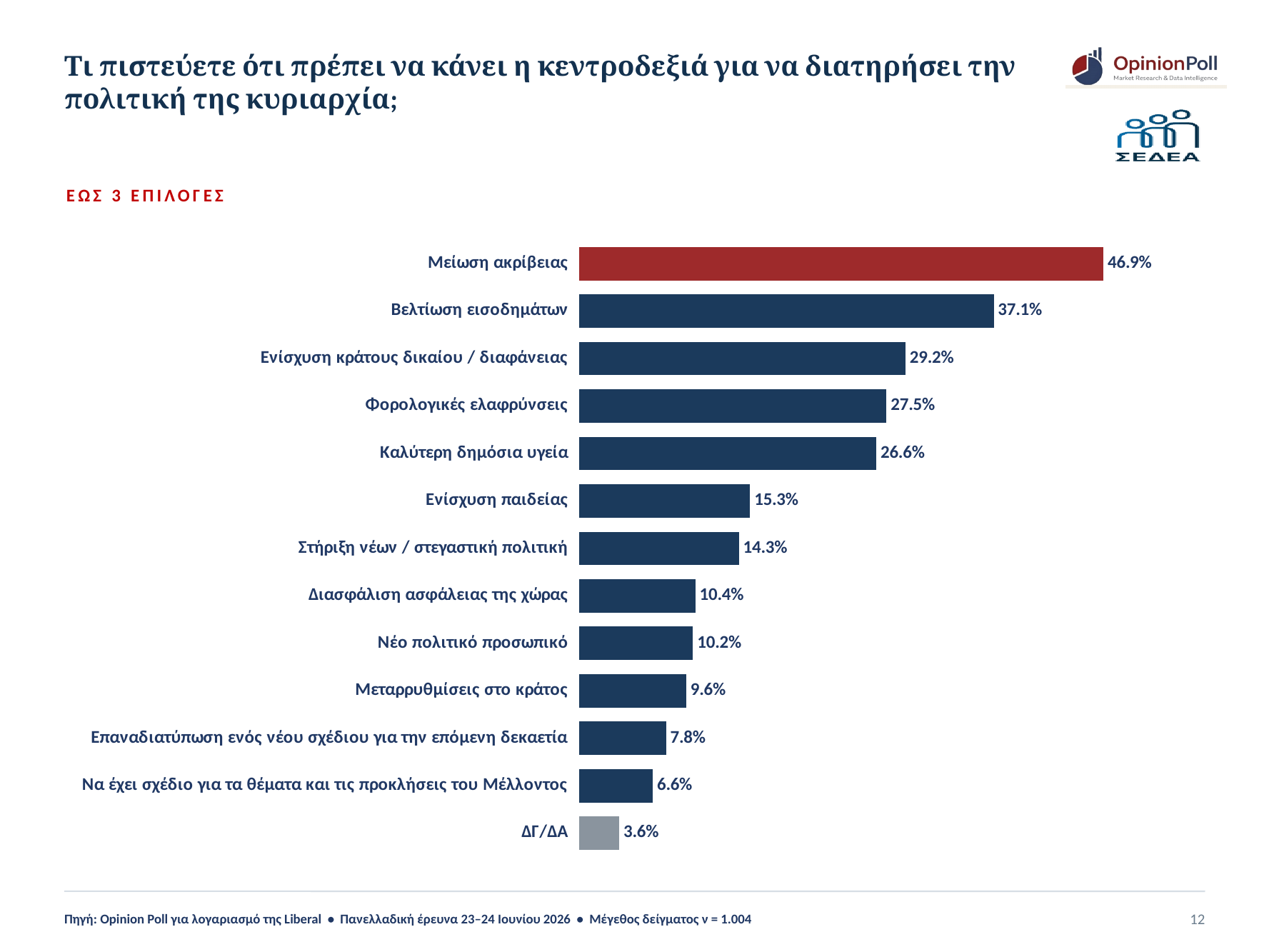
How many categories are shown in the chart? 13 What is the difference between Μείωση ακρίβειας and Βελτίωση εισοδημάτων? 9.8% What kind of chart is shown on the slide? Bar chart What is the value for Φορολογικές ελαφρύνσεις? 27.5% What is the value for Μείωση ακρίβειας? 46.9% Which is larger: Καλύτερη δημόσια υγεία or Ενίσχυση παιδείας? Καλύτερη δημόσια υγεία What is the value for Νέο πολιτικό προσωπικό? 10.2% Which is larger: Μεταρρυθμίσεις στο κράτος or Επαναδιατύπωση ενός νέου σχεδίου για την επόμενη δεκαετία? Μεταρρυθμίσεις στο κράτος Which category has the lowest value? ΔΓ/ΔΑ Which category has the highest value? Μείωση ακρίβειας What is the difference between Ενίσχυση παιδείας and Στήριξη νέων / στεγαστική πολιτική? 1.0% Which bar is coloured red? Μείωση ακρίβειας